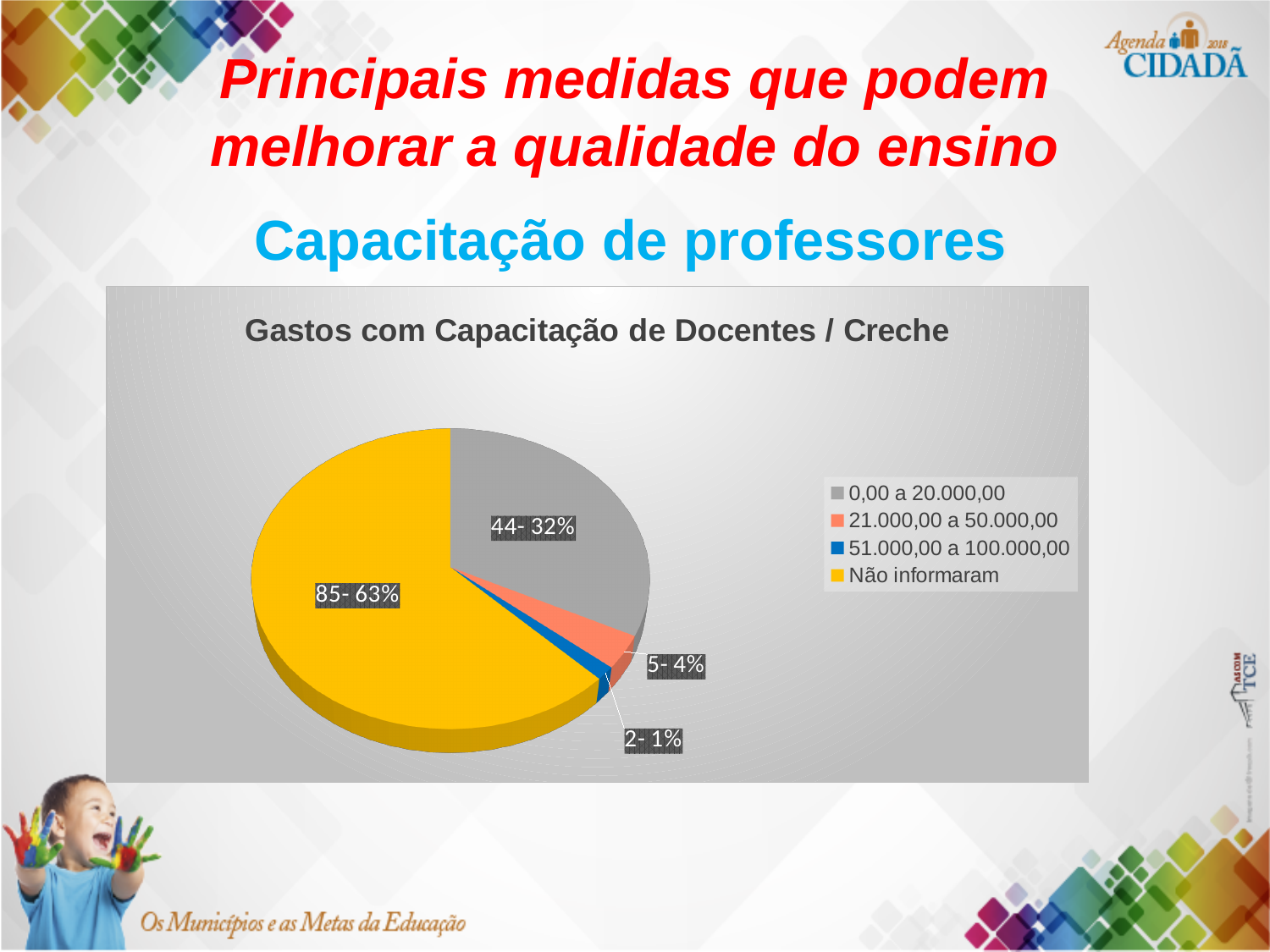
How many slices does the pie chart have? 4 Which category has the largest slice of the pie? Não informaram Which colour represents 'Não informaram' in the pie chart? yellow What percentage share does the '0,00 a 20.000,00' slice have? 32% What kind of chart is shown on the slide? pie chart What count is shown on the data label for '51.000,00 a 100.000,00'? 2 What is the title of the chart? Gastos com Capacitação de Docentes / Creche What is the difference in count between 'Não informaram' and '0,00 a 20.000,00'? 41 Which category has the smallest slice of the pie? 51.000,00 a 100.000,00 What percentage share does the 'Não informaram' slice have? 63% How many entries does the legend list? 4 What count is shown on the data label for '21.000,00 a 50.000,00'? 5